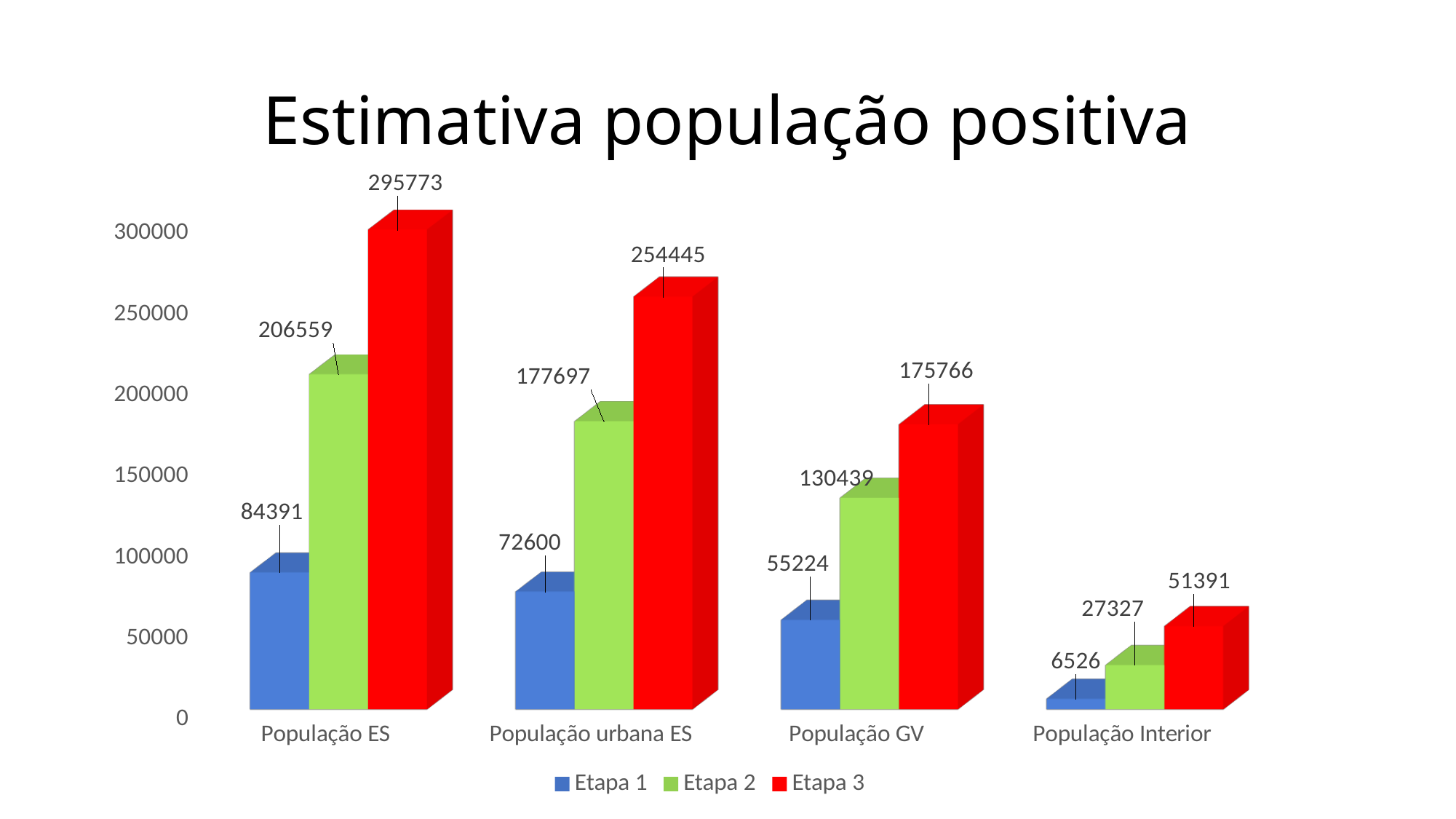
Which is larger: the Etapa 2 value for População urbana ES or the Etapa 3 value for População GV? Etapa 2 value for População urbana ES What kind of chart is shown on the slide? Bar chart Which category has the lowest Etapa 1 value? População Interior How many categories are shown on the x axis? 4 What is the title of the chart? Estimativa população positiva Within each category, do the values rise or fall from Etapa 1 to Etapa 3? Rise What is the value for Etapa 3 in the População ES category? 295773 What is the difference between the Etapa 3 and Etapa 1 values for População urbana ES? 181845 What is the value for Etapa 2 in the População GV category? 130439 How many series does the legend list? 3 Which category has the highest Etapa 3 value? População ES What is the value for Etapa 1 in the População Interior category? 6526